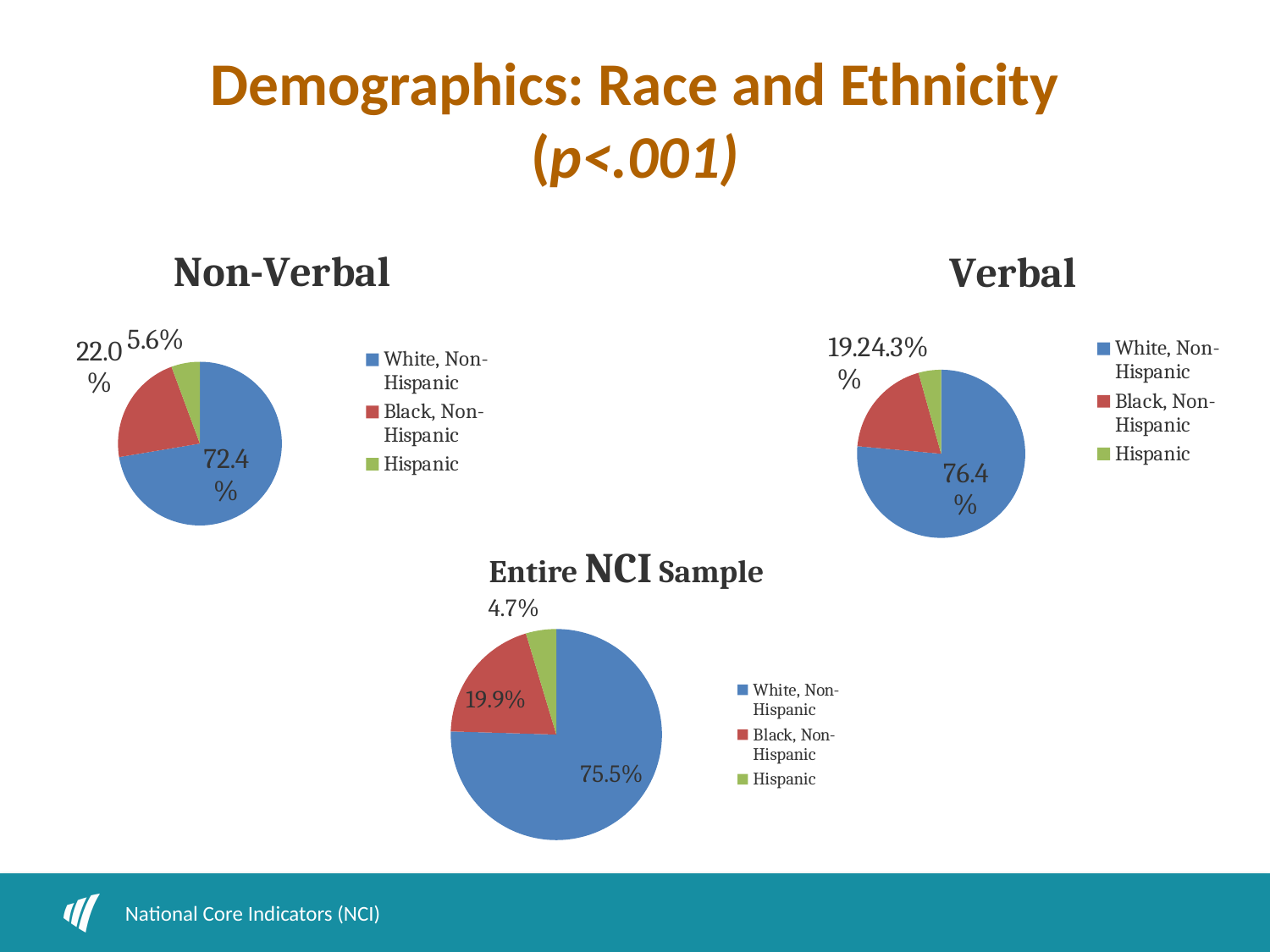
In the Entire NCI Sample pie chart, what share is Black, Non-Hispanic? 19.9% In the Non-Verbal pie chart, what share is Black, Non-Hispanic? 22.0% In the Non-Verbal pie chart, which category has the smallest slice? Hispanic In the Entire NCI Sample pie chart, which category has the largest slice? White, Non-Hispanic What kind of chart is used for the Non-Verbal group? Pie chart How many categories does the legend of the Verbal pie chart list? 3 In the Non-Verbal pie chart, what share is Hispanic? 5.6% What is the difference between the Black, Non-Hispanic share in the Non-Verbal chart and in the Entire NCI Sample chart? 2.1% Which is larger: the White, Non-Hispanic share in the Verbal chart or in the Non-Verbal chart? Verbal In the Non-Verbal pie chart, what share is White, Non-Hispanic? 72.4% In the Verbal pie chart, what share is White, Non-Hispanic? 76.4% In the Entire NCI Sample pie chart, what share is Hispanic? 4.7%